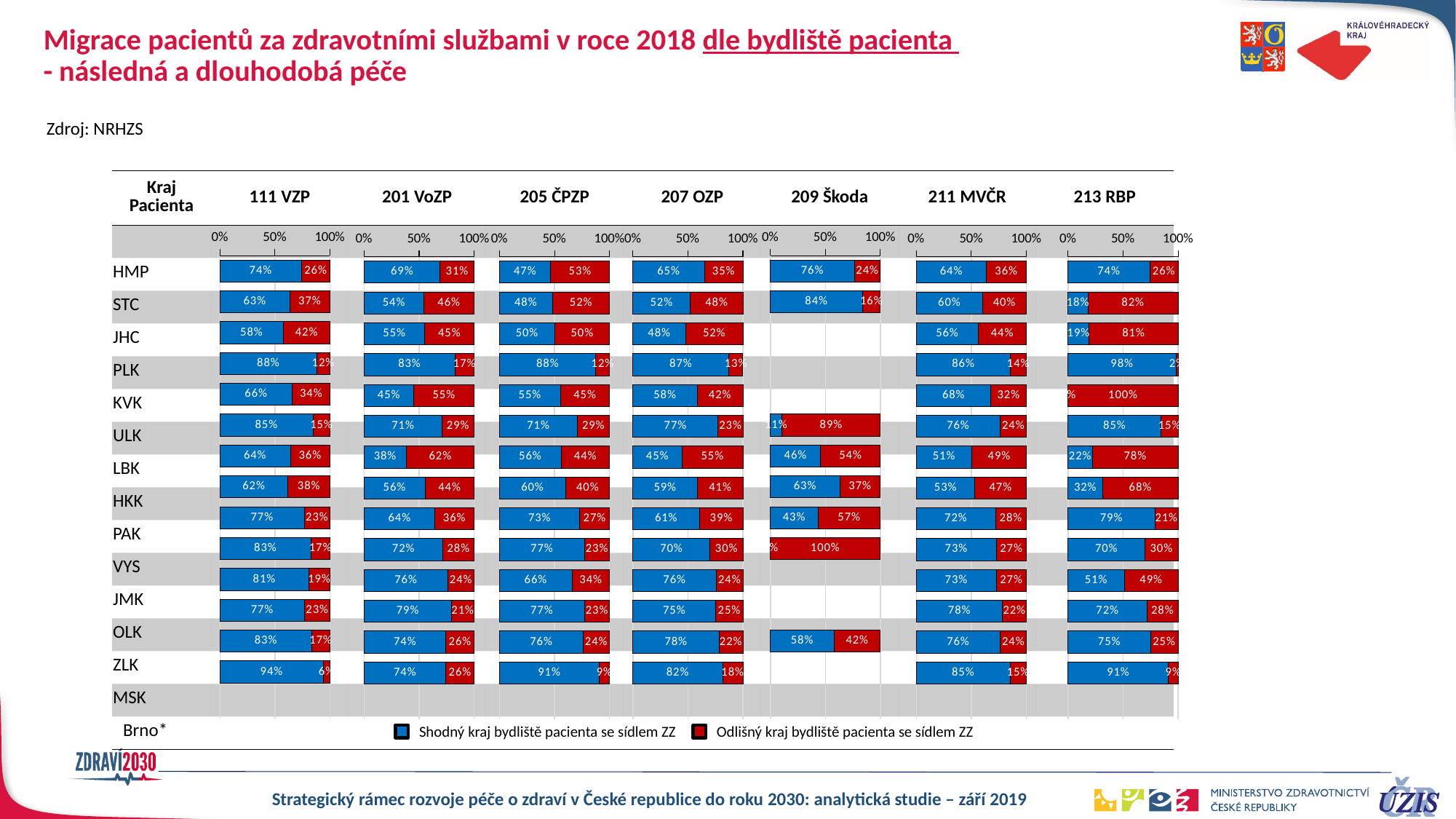
In the 111 VZP chart, what is the value of 'Shodný kraj bydliště pacienta se sídlem ZZ' for HMP? 74% In the 209 Škoda chart, what is the 'Shodný kraj' value for HMP? 76% In the 211 MVČR chart, what is the 'Odlišný kraj' value for STC? 40% In the 213 RBP chart, what is the value of 'Odlišný kraj bydliště pacienta se sídlem ZZ' for STC? 82% For the HMP row, which insurer chart has the highest 'Shodný kraj' share? 209 Škoda How many series does the legend at the bottom of the chart list? 2 What kind of chart is used for each insurer column on the slide? Stacked bar chart In the 111 VZP chart, what is the difference between the 'Shodný kraj' and 'Odlišný kraj' values for HMP? 48 percentage points How many insurer columns (charts) are shown across the slide? 7 For HMP, which chart shows the larger 'Shodný kraj' share: 111 VZP or 205 ČPZP? 111 VZP For the HMP row, which insurer chart has the lowest 'Shodný kraj' share? 205 ČPZP What does the red colour in the legend represent? Odlišný kraj bydliště pacienta se sídlem ZZ